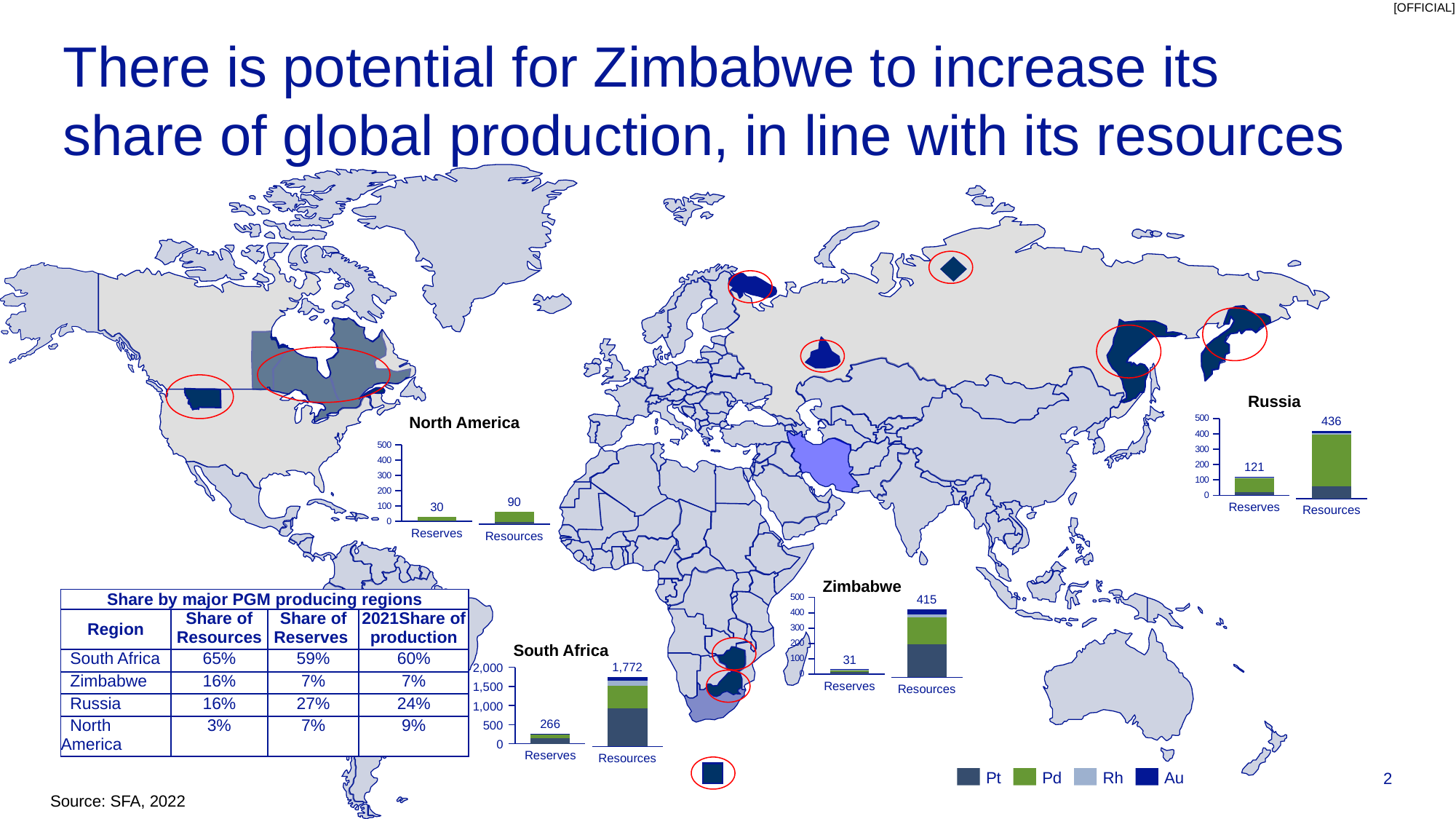
In the Zimbabwe chart, what is the total value shown for Resources? 415 In the South Africa chart, what is the total value shown for Reserves? 266 In the Russia chart, which bar is taller, Reserves or Resources? Resources In the Russia chart, what is the total value shown for Resources? 436 Which colour represents Pd in the legend? Green In the Russia chart, what is the total value shown for Reserves? 121 In the North America chart, is the Resources total greater or less than 100? less In the North America chart, what is the total value shown for Resources? 90 In the Zimbabwe chart, what is the difference between the Resources total and the Reserves total? 384 How many series does the shared legend at the bottom of the slide list? 4 In the South Africa chart, what is the difference between the Resources total and the Reserves total? 1,506 What kind of chart is the South Africa chart? Stacked bar chart